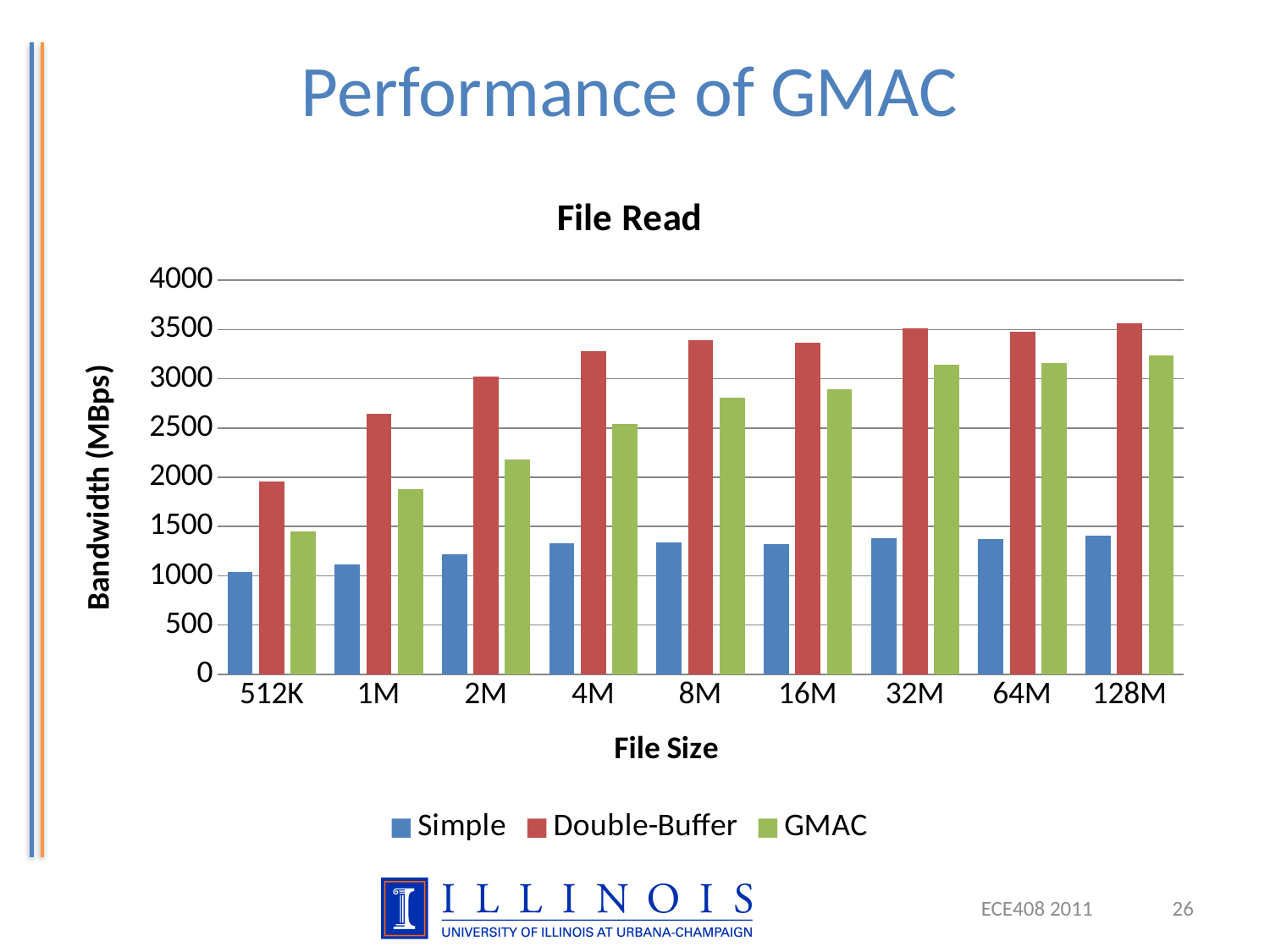
What is the title of the y axis? Bandwidth (MBps) For which file size is the GMAC series lowest? 512K Is the Double-Buffer value for 1M greater or less than 2500? greater How many file size categories are shown on the x axis? 9 At 4M, which is larger: Double-Buffer or GMAC? Double-Buffer Is the Simple value for 128M greater or less than 1500? less How many series does the legend list? 3 What kind of chart is shown on the slide? bar chart For which file size is the Simple series lowest? 512K Is the GMAC value for 128M greater or less than 3000? greater Does the GMAC series generally rise or fall as file size increases? rise